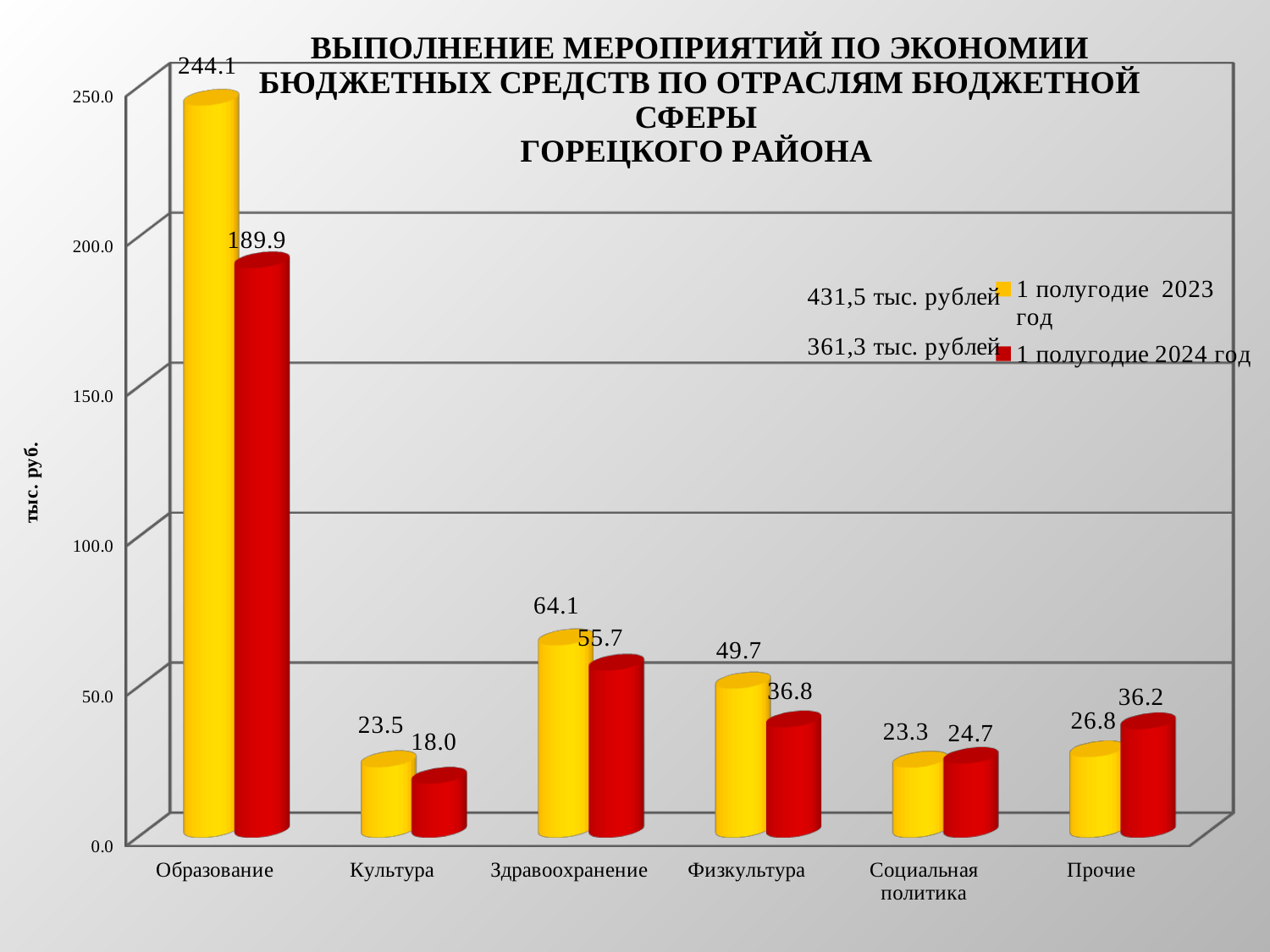
What unit is shown on the vertical axis label? тыс. руб. How many categories are shown on the x axis? 6 Is the value for Физкультура in the 1 полугодие 2023 год series greater or less than 50.0? less What is the difference between the 1 полугодие 2023 год and 1 полугодие 2024 год values for Образование? 54.2 Which category has the highest value in the 1 полугодие 2024 год series? Образование What is the value for Образование in the 1 полугодие 2023 год series? 244.1 Which category has the lowest value in the 1 полугодие 2024 год series? Культура What is the value for Социальная политика in the 1 полугодие 2023 год series? 23.3 For Прочие, which series has the larger value: 1 полугодие 2023 год or 1 полугодие 2024 год? 1 полугодие 2024 год What kind of chart is shown on the slide? bar chart How many series does the legend list? 2 What is the value for Здравоохранение in the 1 полугодие 2024 год series? 55.7